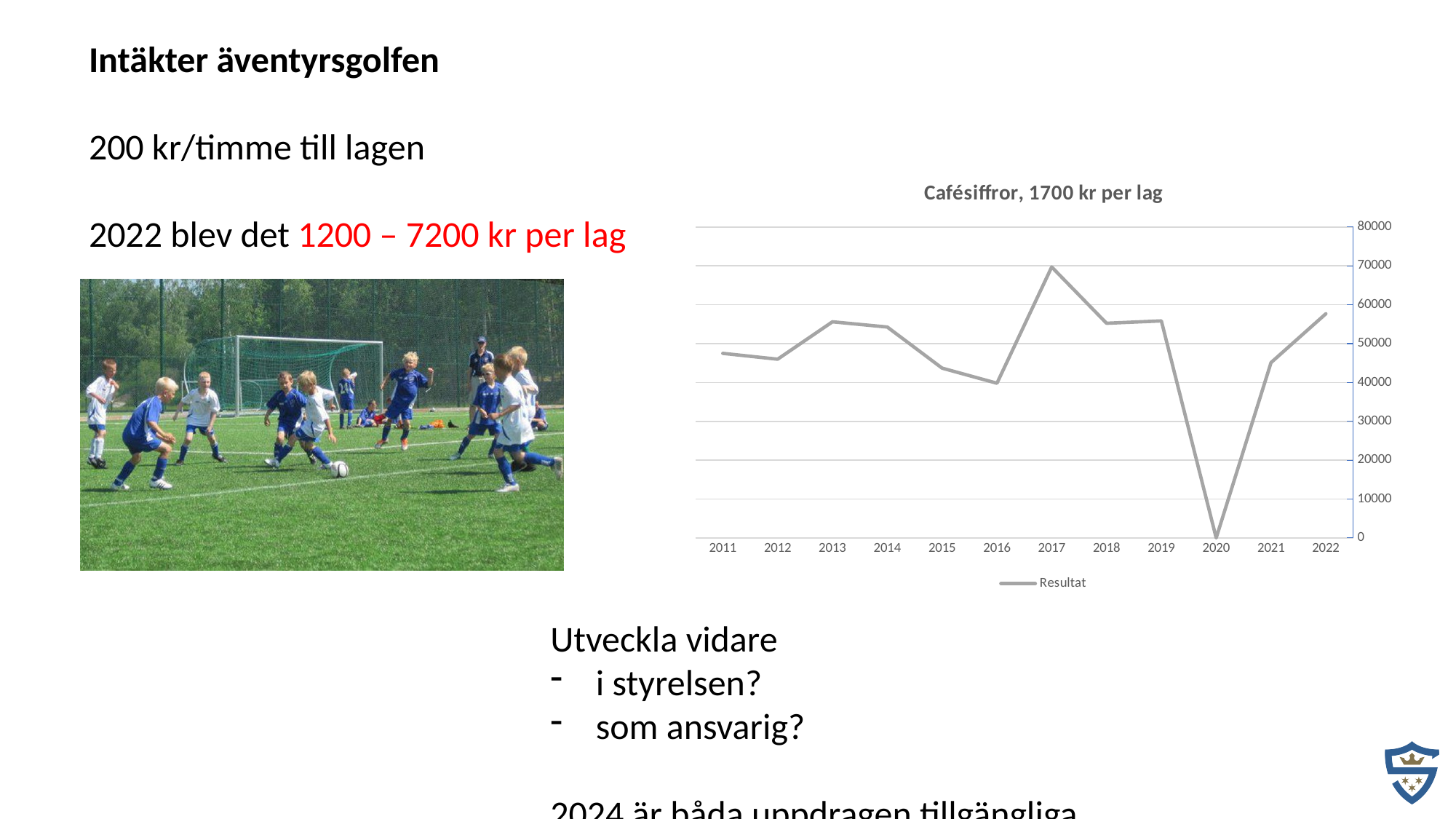
Is the Resultat value for 2017 greater or less than 60000? greater How many years are plotted along the x axis? 12 What kind of chart is shown on the slide? line chart Which year has the lowest Resultat value? 2020 Which year has the highest Resultat value? 2017 Does the Resultat value rise or fall from 2019 to 2020? fall Which year has the larger Resultat value, 2017 or 2016? 2017 Is the Resultat value for 2020 greater or less than 10000? less What is the title of the chart? Cafésiffror, 1700 kr per lag Is the Resultat value for 2016 greater or less than 50000? less How many series does the chart legend list? 1 What is the name of the series shown in the legend? Resultat